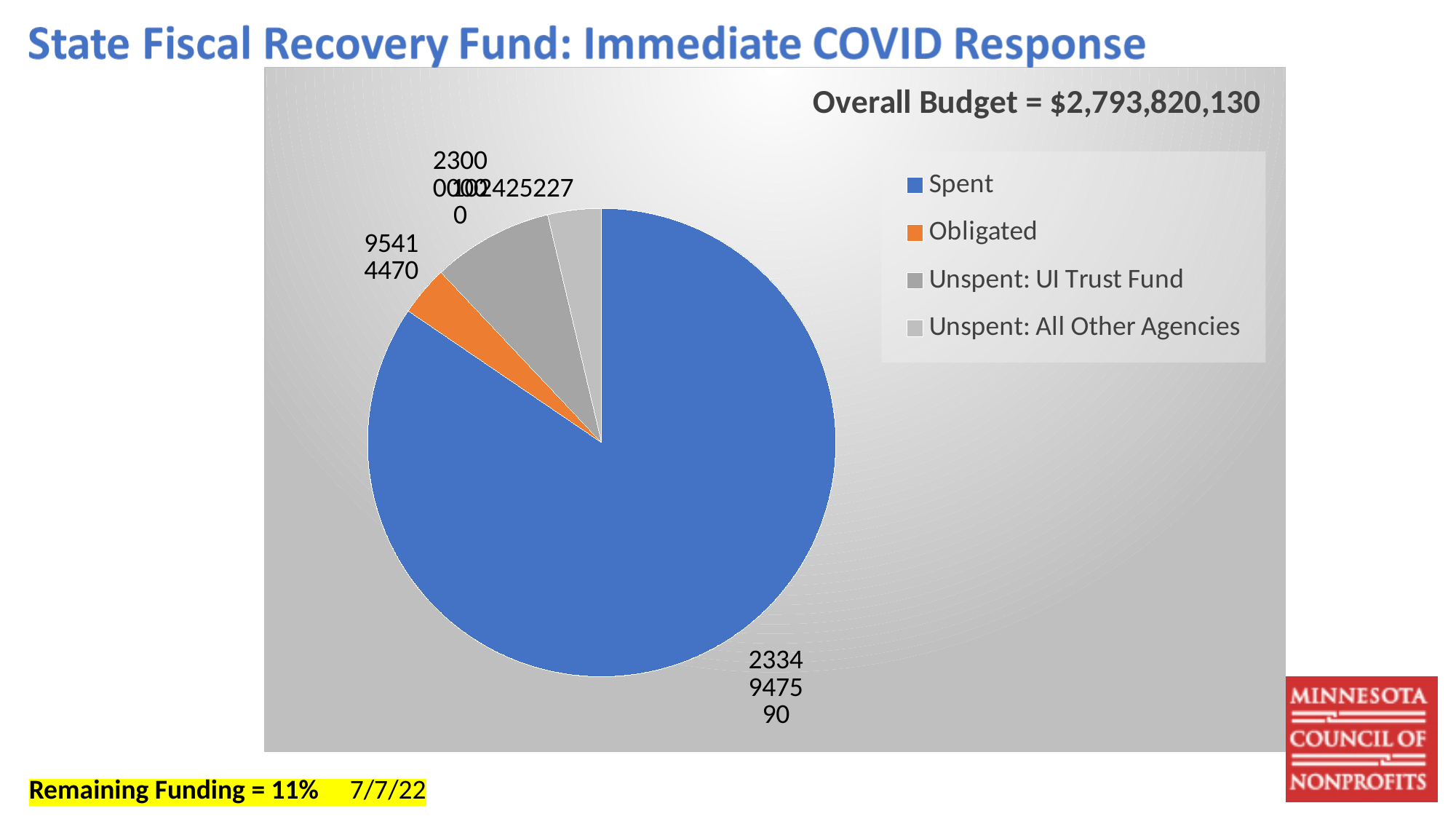
How many entries does the legend list? 4 What kind of chart is shown on the slide? pie chart How many slices does the pie chart have? 4 What overall budget is stated on the chart? $2,793,820,130 Which category has the largest slice of the pie? Spent What is the value shown for the Obligated slice? 95414470 Which is larger, the Spent slice or the Obligated slice? Spent What is the title of the slide? State Fiscal Recovery Fund: Immediate COVID Response Which is larger, the Unspent: UI Trust Fund slice or the Obligated slice? Unspent: UI Trust Fund What is the difference between the Spent value and the Obligated value? 2239533120 What is the value shown for the Spent slice? 2334947590